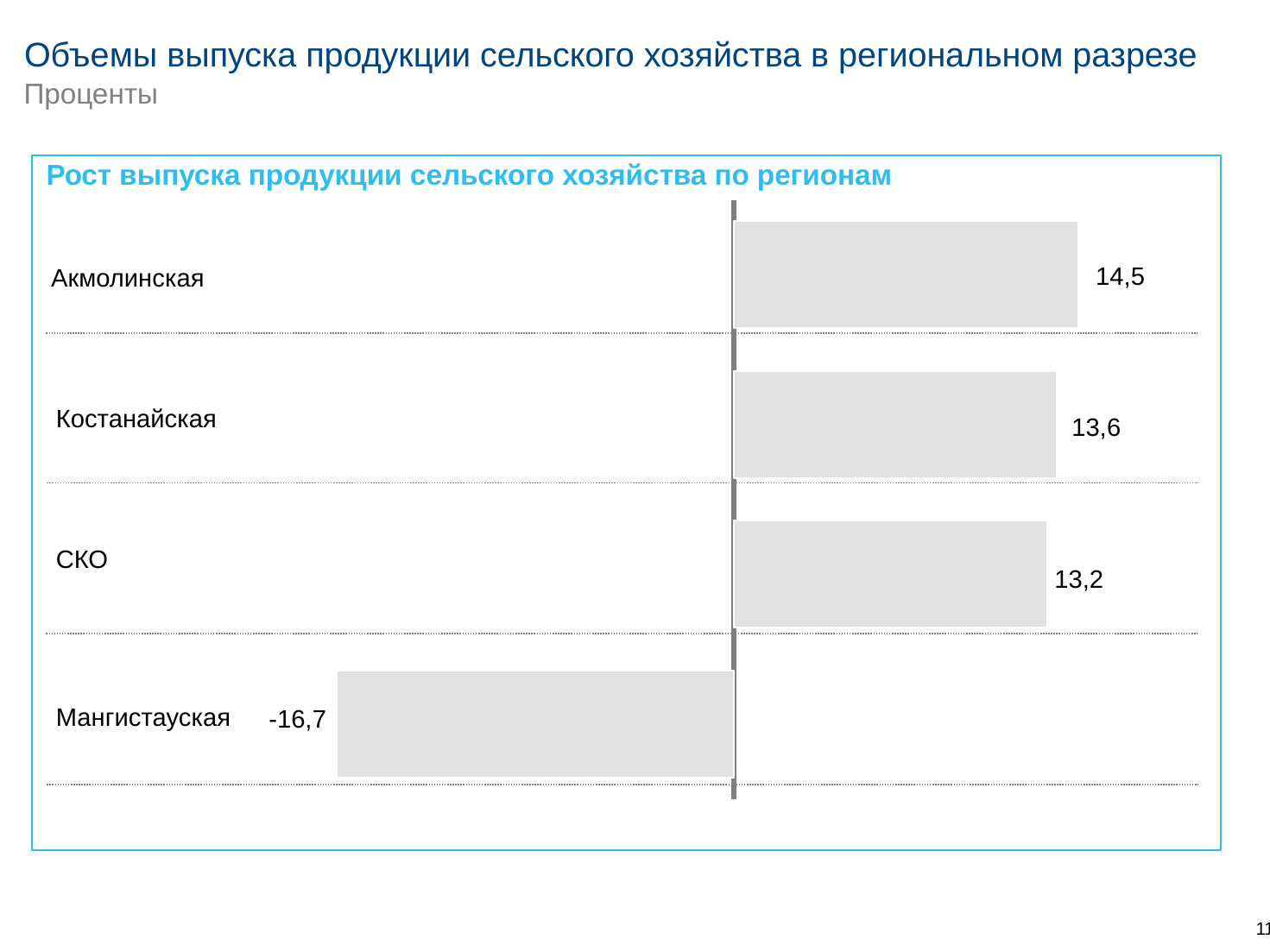
What is the value for Костанайская? 13,6 What is the value for СКО? 13,2 Which is larger, the value for Костанайская or the value for СКО? Костанайская What is the title of the chart? Рост выпуска продукции сельского хозяйства по регионам What is the difference between the values for Костанайская and Мангистауская? 30,3 What is the value for Акмолинская? 14,5 What is the difference between the values for Акмолинская and СКО? 1,3 Which region has the highest value? Акмолинская What is the value for Мангистауская? -16,7 What kind of chart is shown on the slide? Bar chart How many regions are shown in the chart? 4 Which region has the lowest value? Мангистауская